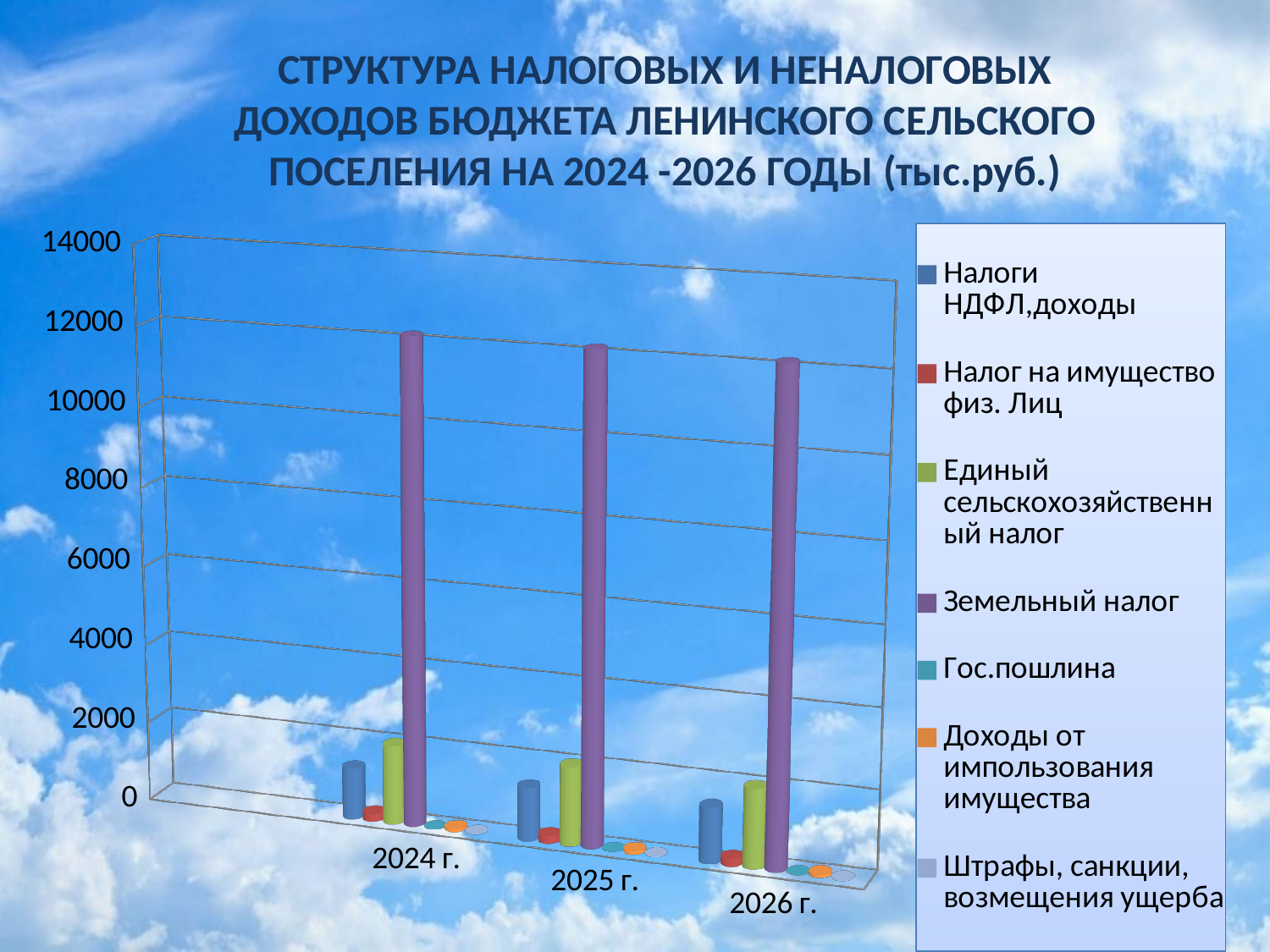
Is the value for Налоги НДФЛ,доходы in 2025 г. greater or less than 2000? less Which is larger in 2024 г.: Единый сельскохозяйственный налог or Налоги НДФЛ,доходы? Единый сельскохозяйственный налог What kind of chart is shown on the slide? bar chart How many years (categories) are shown on the x axis? 3 Which series has the highest value in 2024 г.? Земельный налог Which series has the highest value in 2026 г.? Земельный налог What colour represents Земельный налог in the legend? purple Is the value for Земельный налог in 2026 г. greater or less than 8000? greater Is the value for Земельный налог in 2024 г. greater or less than 10000? greater How many series does the legend list? 7